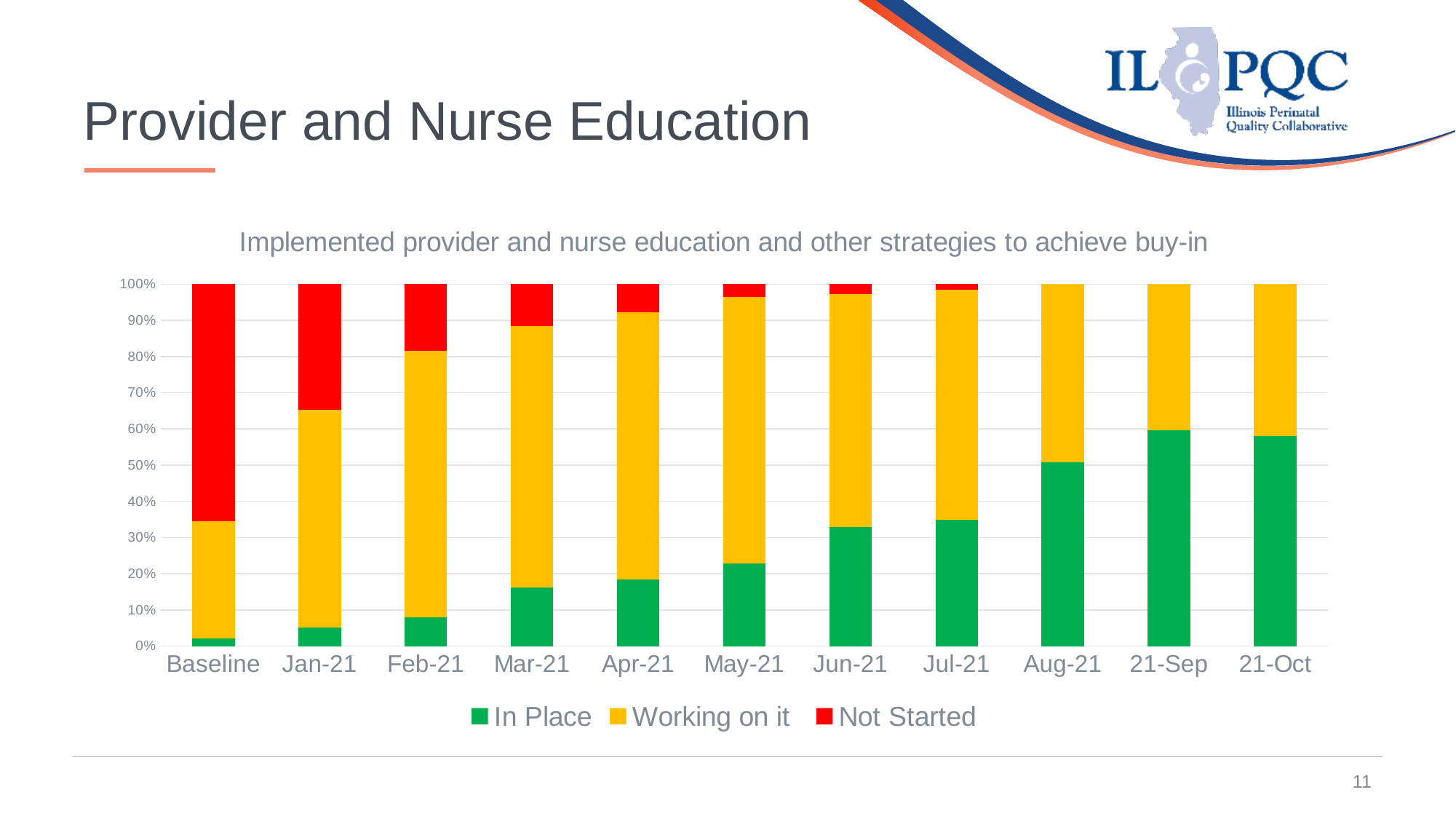
Which colour represents the "In Place" series in the chart? Green Is the "In Place" value for Baseline greater or less than 10%? less Which category has the largest "Not Started" segment? Baseline How many categories show no "Not Started" segment at all? 3 What is the title of the chart? Implemented provider and nurse education and other strategies to achieve buy-in Is the "Not Started" share for Baseline greater or less than 50%? greater How many time-period categories are shown along the x axis of the chart? 11 How many series does the chart's legend list? 3 Does the "In Place" share rise or fall from Baseline to Aug-21? rises Is the "In Place" value for Aug-21 greater or less than 40%? greater Which has the larger "Not Started" segment, Jan-21 or Feb-21? Jan-21 What kind of chart is shown on the slide? Stacked bar chart